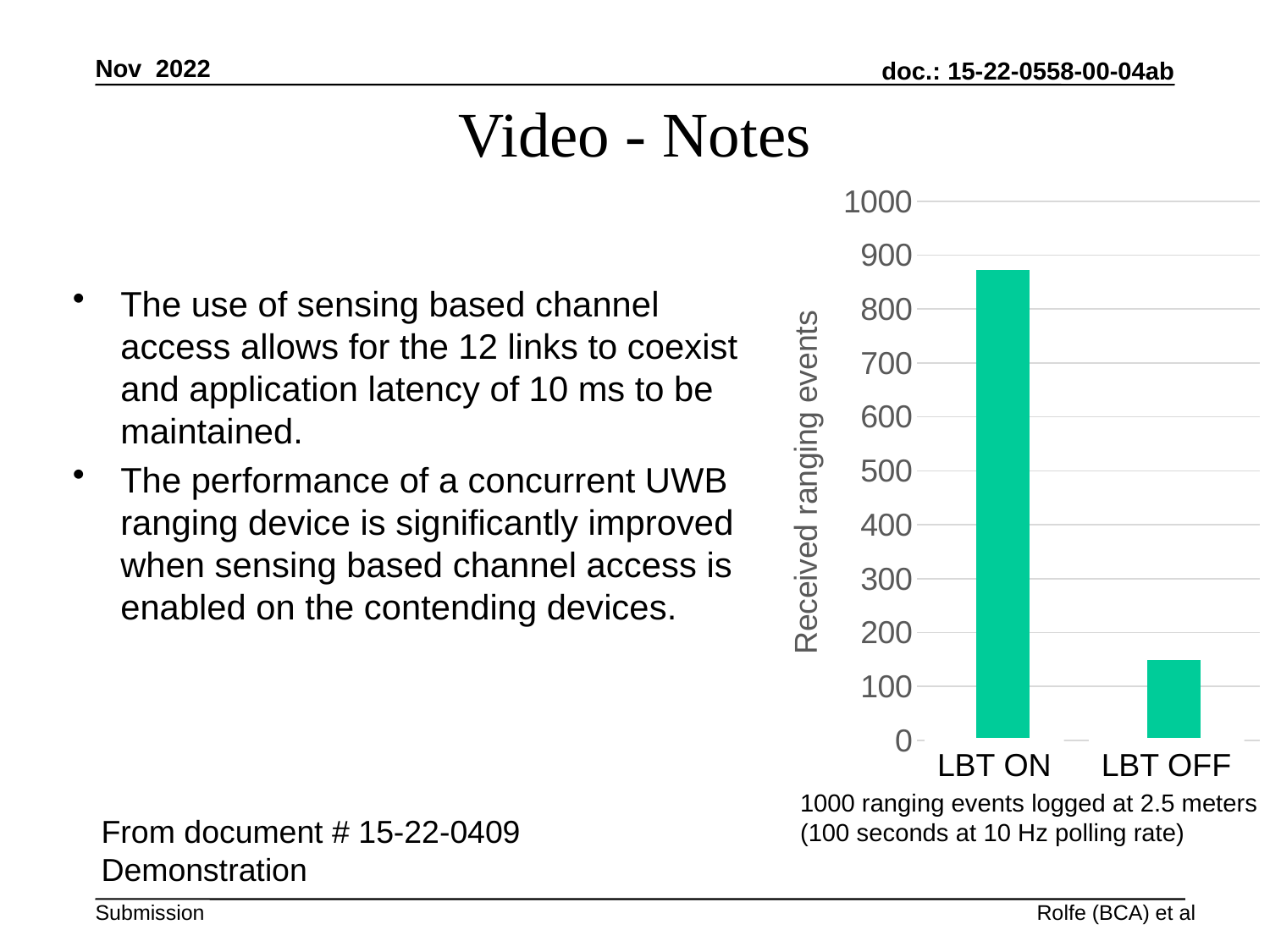
Is the value for LBT ON greater or less than 900? less Is the value for LBT OFF greater or less than 100? greater Which is larger, the value for LBT ON or the value for LBT OFF? LBT ON Is the value for LBT OFF greater or less than 200? less What is the highest tick value shown on the vertical axis of the chart? 1000 Which category has the lowest number of received ranging events? LBT OFF How many categories are plotted on the x axis of the chart? 2 What kind of chart is shown on the slide? bar chart What is the label on the vertical axis of the chart? Received ranging events Which category has the highest number of received ranging events? LBT ON